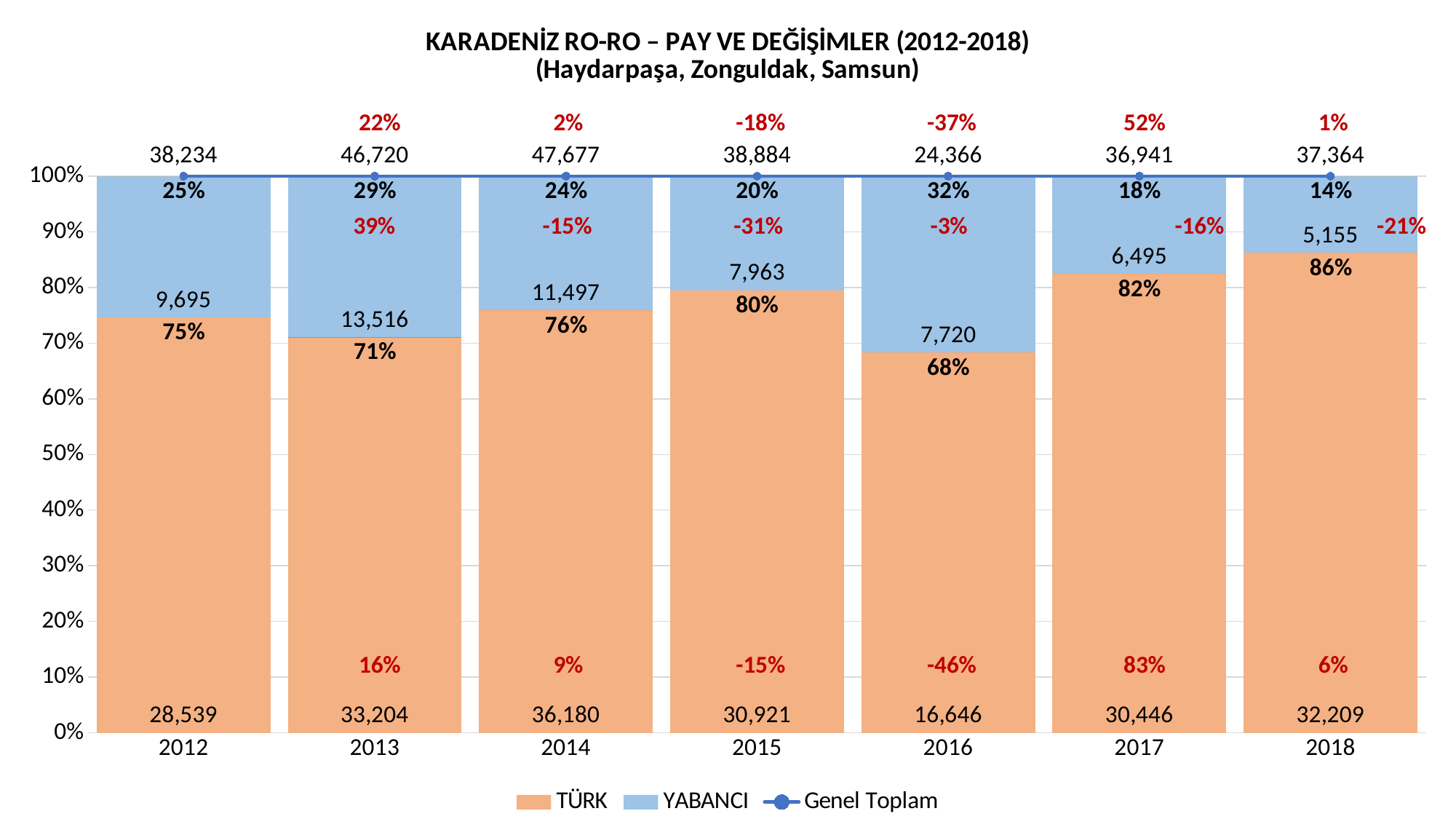
What kind of chart is this? Stacked bar chart with a line How many series does the legend list? 3 In which year is the Genel Toplam value highest? 2014 What is the YABANCI value for 2016? 7,720 What percentage share does YABANCI have in 2016? 32% In which year is the Genel Toplam value lowest? 2016 Which year has the larger YABANCI value, 2013 or 2014? 2013 How many years are shown on the x axis? 7 What is the TÜRK value for 2014? 36,180 What is the difference between the TÜRK values for 2013 and 2012? 4,665 What is the Genel Toplam value for 2013? 46,720 What percentage share does TÜRK have in 2018? 86%